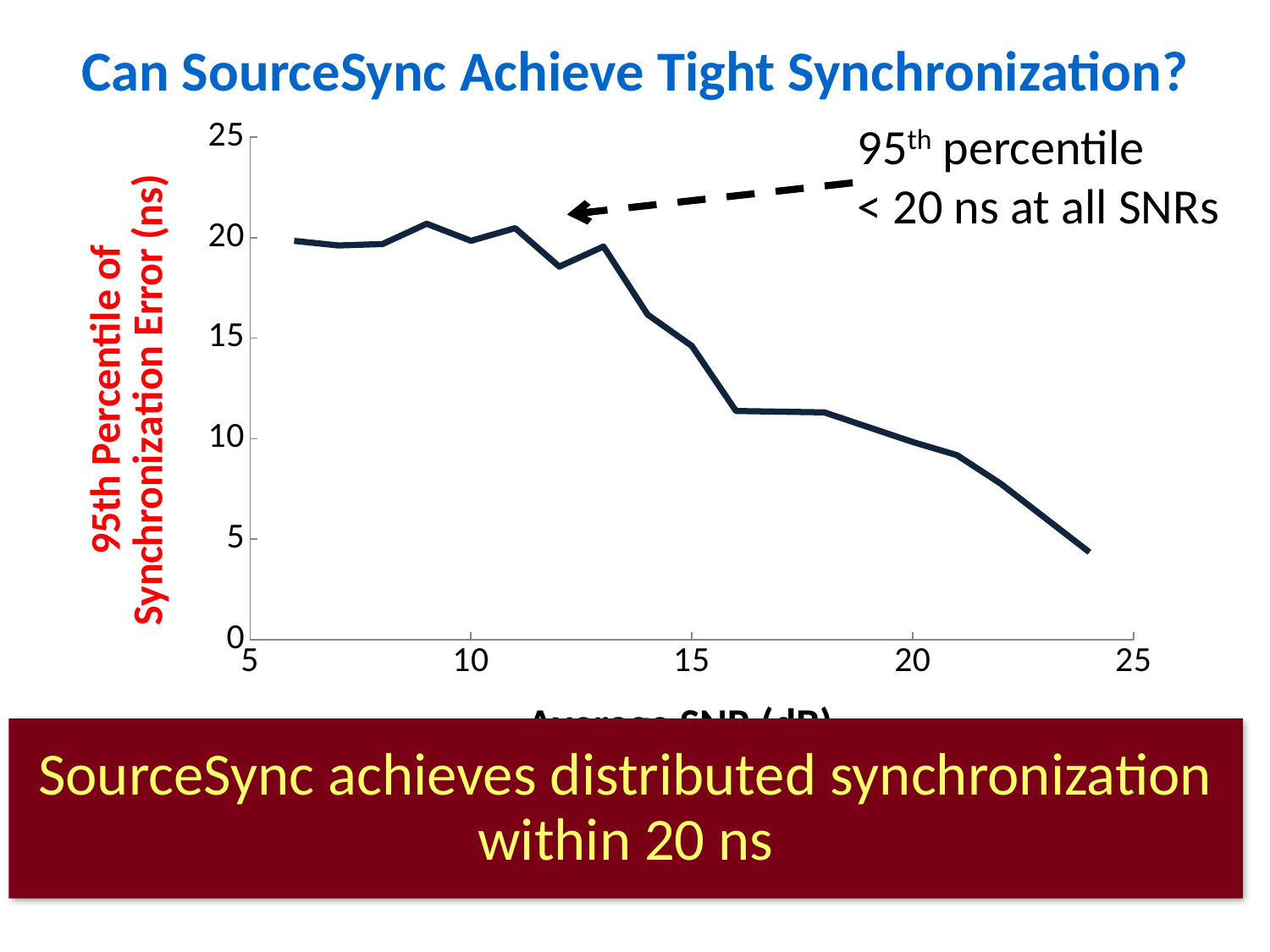
Is the 95th percentile synchronization error at an average SNR of 24 dB greater or less than 5? less What does the annotation with the dashed arrow on the chart say? 95th percentile < 20 ns at all SNRs Is the 95th percentile synchronization error at an average SNR of 14 dB greater or less than 15? greater Which has the larger 95th percentile synchronization error: an average SNR of 13 dB or 18 dB? 13 dB What kind of chart is shown on the slide? line chart Is the 95th percentile synchronization error at an average SNR of 16 dB greater or less than 10? greater Does the 95th percentile synchronization error rise or fall as average SNR increases? fall What is the label on the y axis of the chart? 95th Percentile of Synchronization Error (ns)